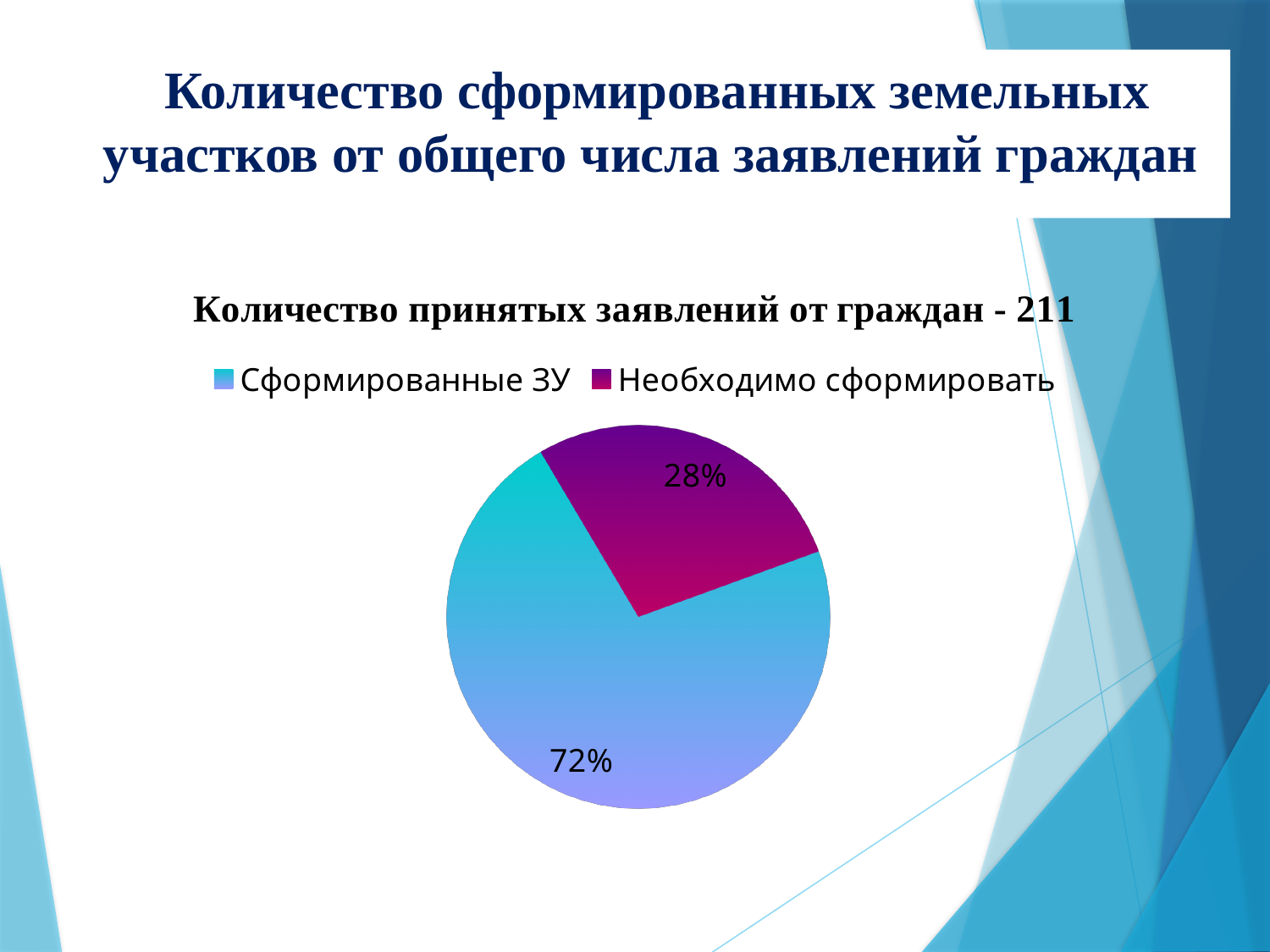
What share of the pie does "Сформированные ЗУ" take? 72% Which slice of the pie is the largest? Сформированные ЗУ Which is larger: the "Сформированные ЗУ" slice or the "Необходимо сформировать" slice? Сформированные ЗУ What is the difference in percentage points between the "Сформированные ЗУ" slice and the "Необходимо сформировать" slice? 44 What is the title of the chart? Количество принятых заявлений от граждан - 211 How many entries does the legend list? 2 What colour is the "Необходимо сформировать" slice? purple Which slice of the pie is the smallest? Необходимо сформировать How many slices does the pie chart have? 2 What share of the pie does "Необходимо сформировать" take? 28% What kind of chart is shown on the slide? pie chart